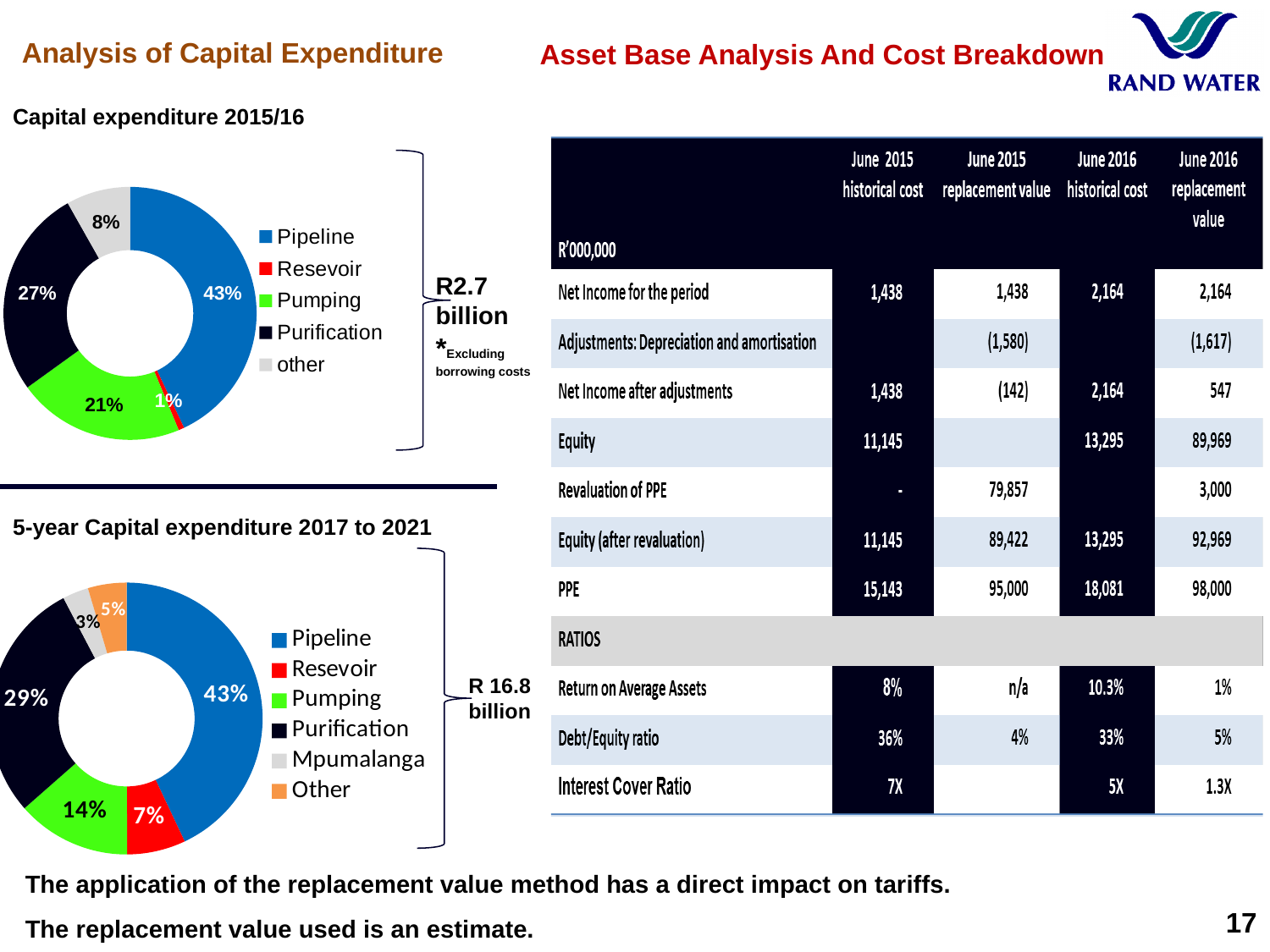
In the 'Capital expenditure 2015/16' chart, which category has the smallest share? Resevoir In the '5-year Capital expenditure 2017 to 2021' chart, which category has the smallest share? Mpumalanga In the '5-year Capital expenditure 2017 to 2021' chart, how many categories does the legend list? 6 In the '5-year Capital expenditure 2017 to 2021' chart, what share does Resevoir have? 7% In the 'Capital expenditure 2015/16' chart, what share does Purification have? 27% In the '5-year Capital expenditure 2017 to 2021' chart, which category has the largest share? Pipeline What kind of chart is used for 'Capital expenditure 2015/16'? Doughnut chart In the 'Capital expenditure 2015/16' chart, how many categories does the legend list? 5 In the '5-year Capital expenditure 2017 to 2021' chart, what share does Purification have? 29% In the '5-year Capital expenditure 2017 to 2021' chart, which is larger, Pumping or Resevoir? Pumping In the 'Capital expenditure 2015/16' chart, what is the difference between the Pumping and other shares? 13% In the 'Capital expenditure 2015/16' chart, what share does Pipeline have? 43%